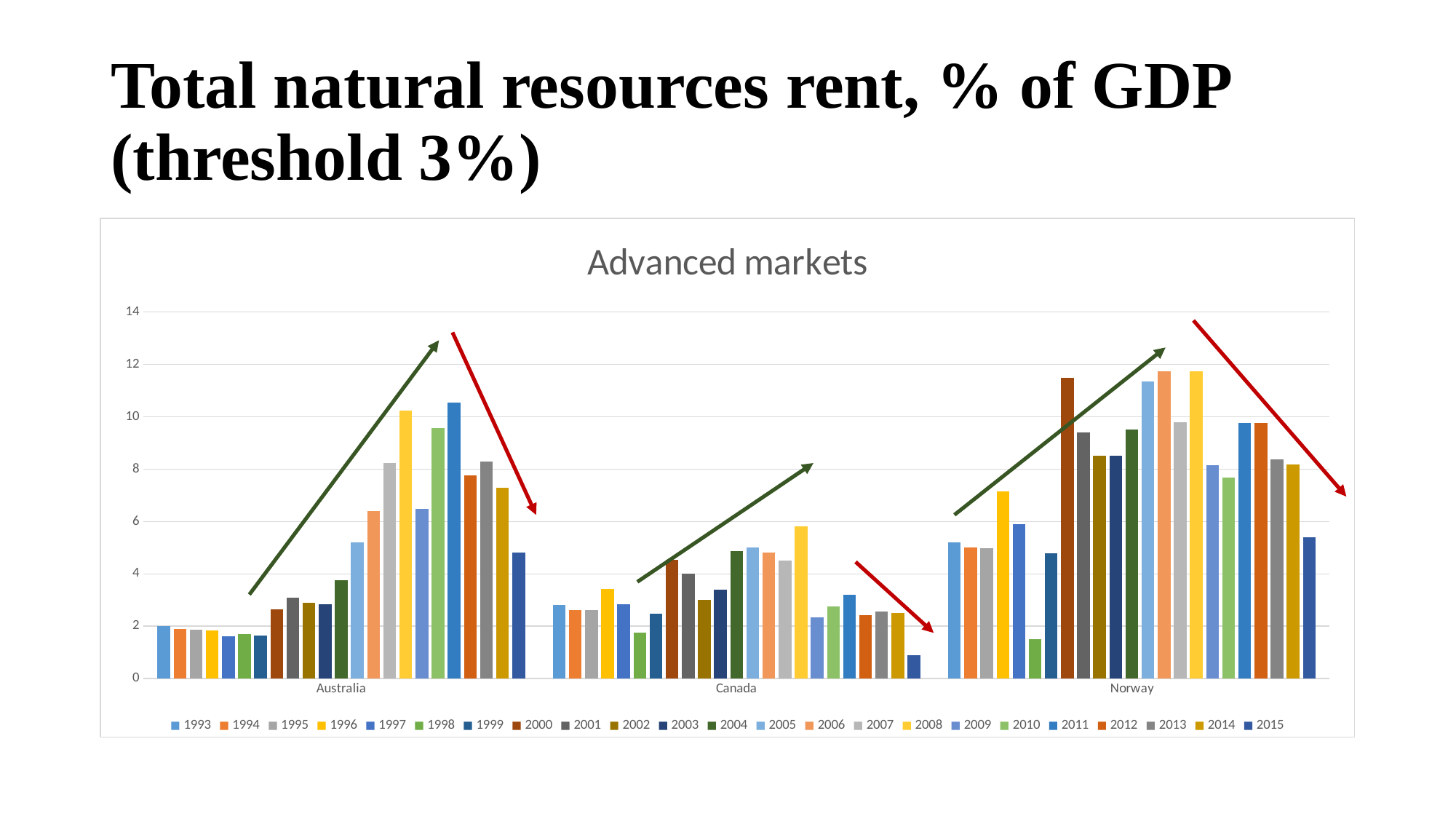
Is the value for Australia in 2011 greater or less than 10? greater Which year has the lowest value for Canada? 2015 Is the value for Norway in 2000 greater or less than 10? greater How many countries are shown on the x axis of the chart? 3 What is the title of the chart? Advanced markets Is the value for Norway in 2010 greater or less than 2? greater How many series (years) does the legend list? 23 Which year has the lowest value for Norway? 1998 Which is larger, the value for Australia in 2011 or the value for Canada in 2011? Australia in 2011 What kind of chart is shown on the slide? bar chart